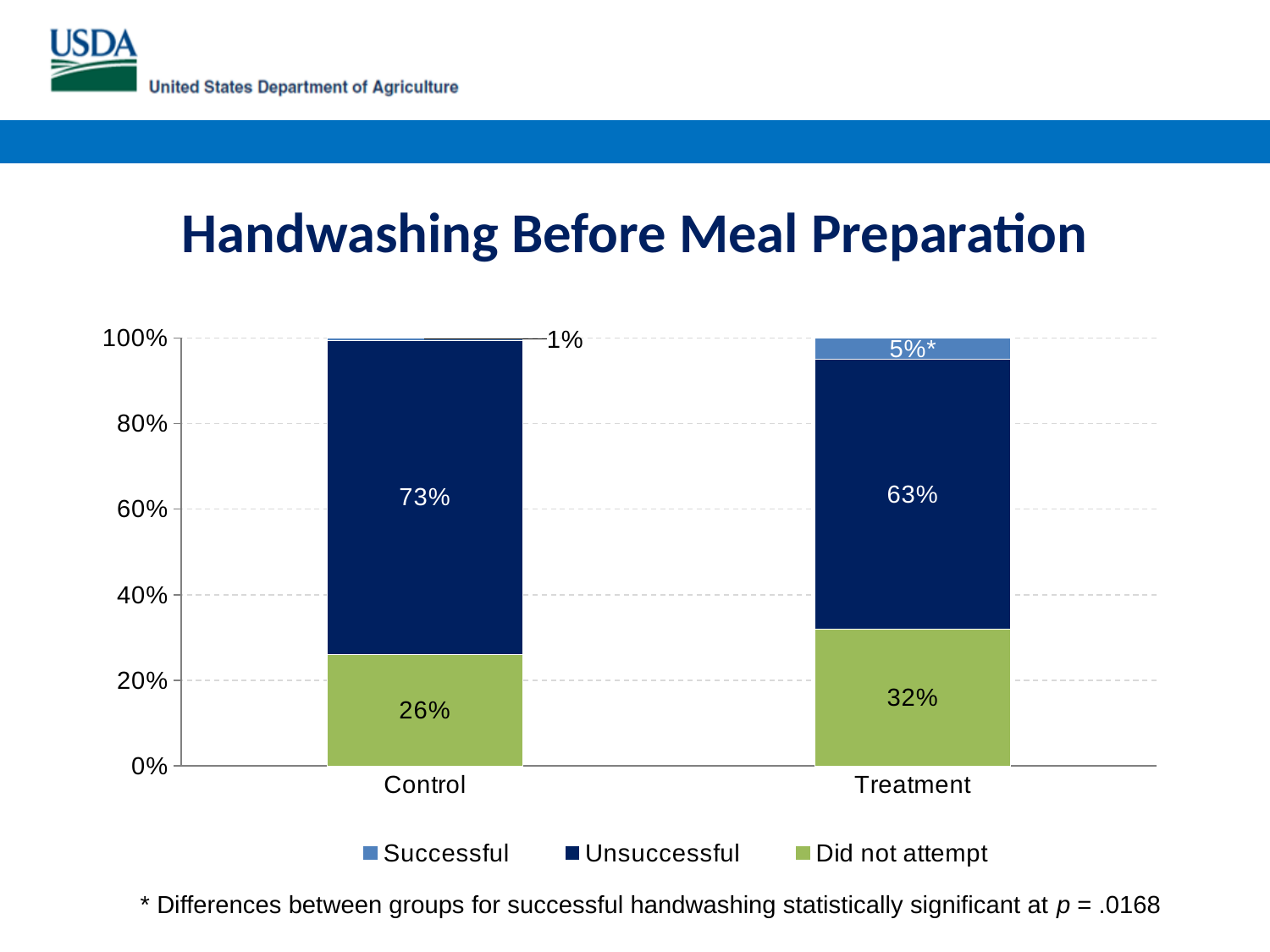
What is the Successful value for the Control group? 1% What is the difference between the Did not attempt values for Treatment and Control? 6% What is the difference between the Unsuccessful values for Control and Treatment? 10% What kind of chart is shown? Stacked bar chart Which group has the higher Unsuccessful value? Control Which series is shown in green in the legend? Did not attempt What is the Did not attempt value for the Treatment group? 32% How many groups are shown on the x axis? 2 What is the Unsuccessful value for the Control group? 73% How many series does the legend list? 3 What is the Successful value for the Treatment group? 5%* What is the title of the chart? Handwashing Before Meal Preparation